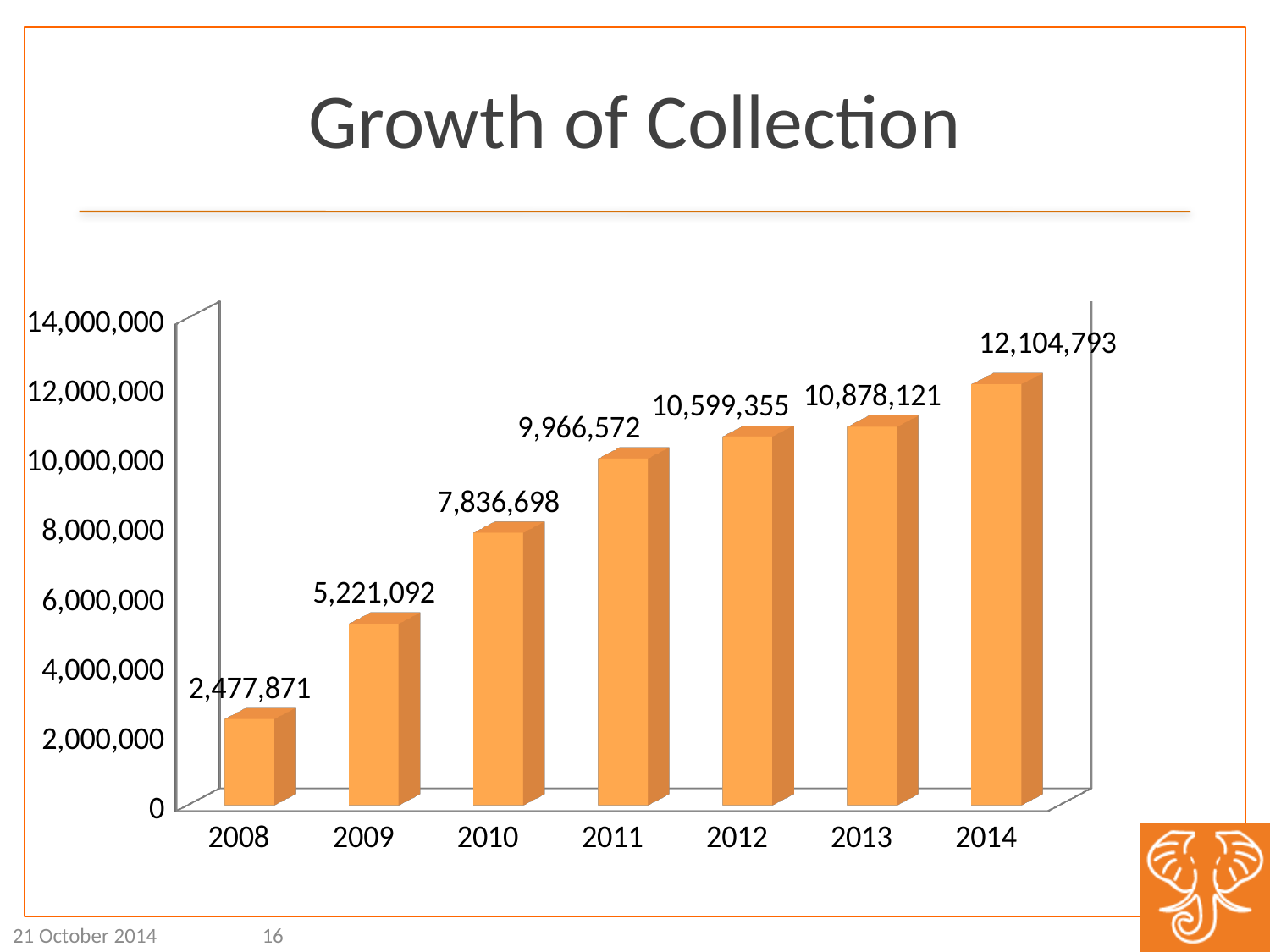
Which year has the highest value? 2014 What is the value for 2011? 9,966,572 What is the value for 2014? 12,104,793 Do the values rise or fall from 2008 to 2014? rise How many years are shown on the x axis? 7 What is the difference between the values for 2009 and 2008? 2,743,221 Which year has the lowest value? 2008 What is the value for 2008? 2,477,871 What kind of chart is shown on the slide? bar chart Which is larger, the value for 2010 or the value for 2012? 2012 Is the value for 2010 greater or less than 8,000,000? less What is the difference between the values for 2014 and 2008? 9,626,922